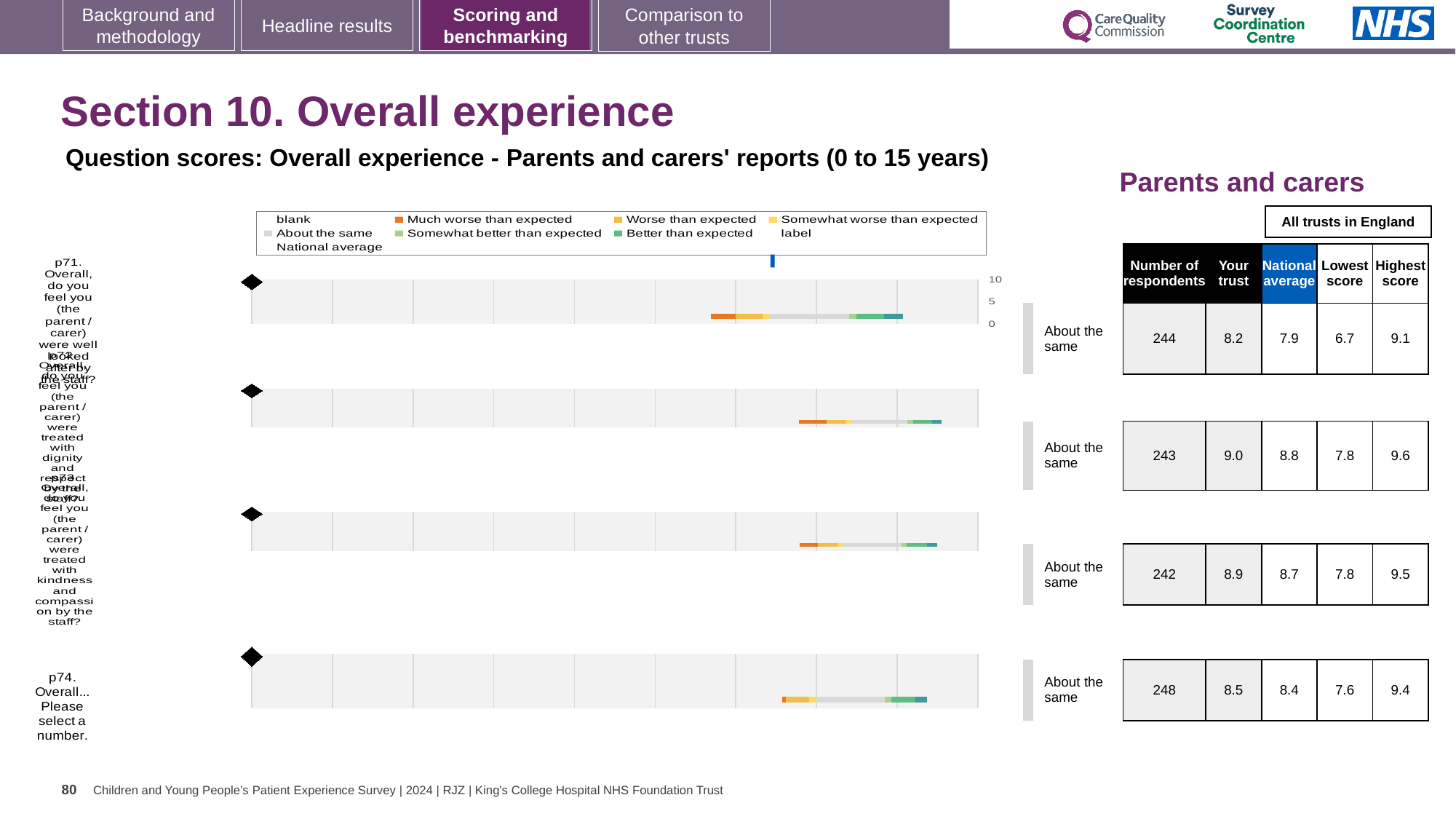
What is the number of respondents for p74 (Overall... Please select a number)? 248 For p74, what is the difference between the highest score and the lowest score across all trusts in England? 1.8 What is the title of the chart? Question scores: Overall experience - Parents and carers' reports (0 to 15 years) What kind of chart is used to show the question scores on this slide? bar chart Which colour does the legend use for 'Much worse than expected'? orange How many question rows are plotted in the chart? 4 What is the highest 'Your trust' score shown across the four question rows? 9.0 What is the lowest value in the 'Lowest score' column across the four question rows? 6.7 For p71, which is larger: the 'Your trust' score or the national average? Your trust What is the 'Your trust' score for p74 (Overall... Please select a number)? 8.5 What is the 'Your trust' score for p71 (Overall, do you feel you were well looked after by the staff?)? 8.2